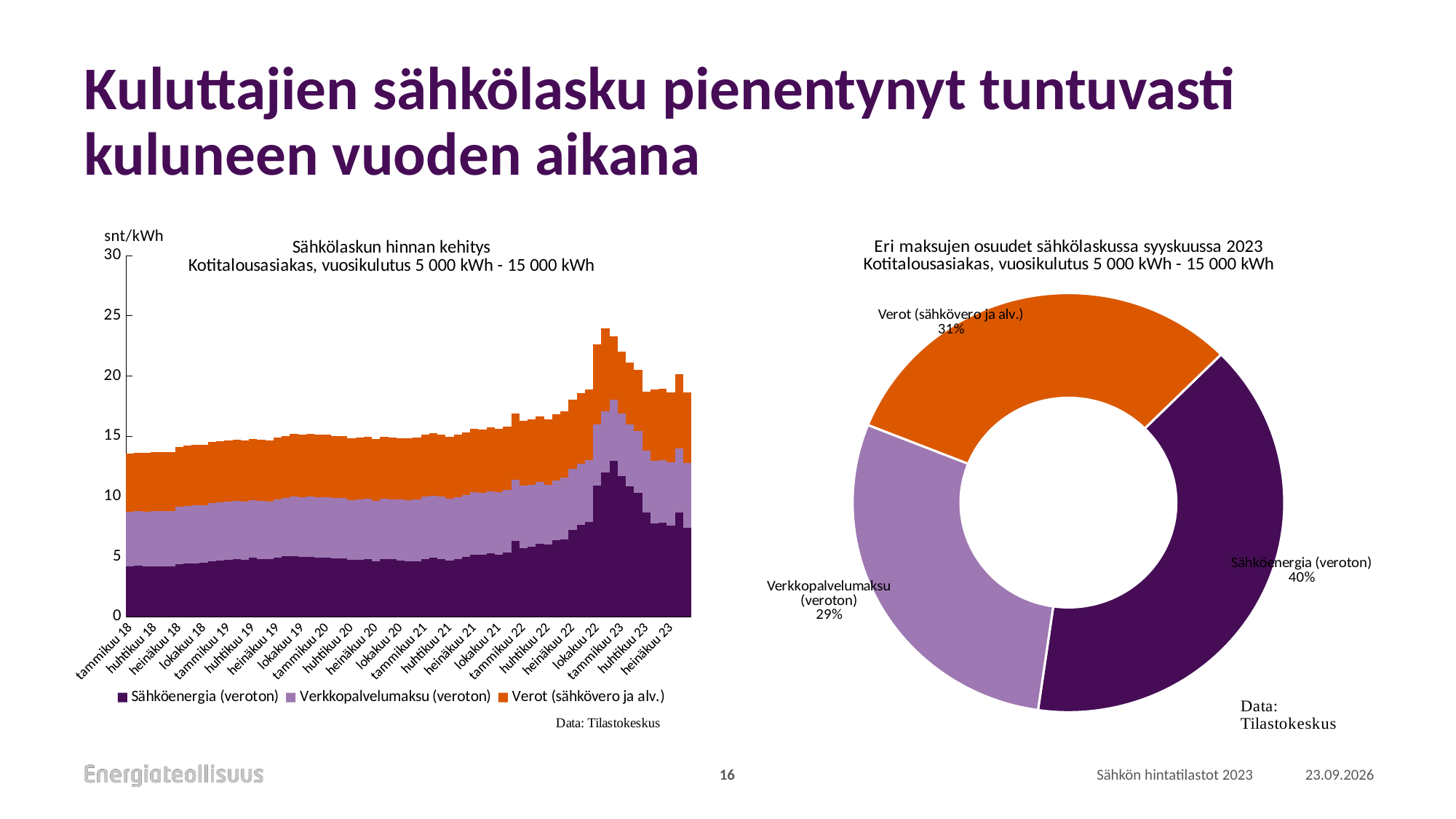
What kind of chart is 'Sähkölaskun hinnan kehitys'? Stacked bar chart In the chart 'Eri maksujen osuudet sähkölaskussa syyskuussa 2023', how many percentage points larger is the share of Sähköenergia (veroton) than that of Verot (sähkövero ja alv.)? 9 percentage points What kind of chart is 'Eri maksujen osuudet sähkölaskussa syyskuussa 2023'? Pie (donut) chart In the chart 'Eri maksujen osuudet sähkölaskussa syyskuussa 2023', how many slices are there? 3 How many series does the legend of the chart 'Sähkölaskun hinnan kehitys' list? 3 In the chart 'Eri maksujen osuudet sähkölaskussa syyskuussa 2023', what share does Sähköenergia (veroton) have? 40% In the chart 'Eri maksujen osuudet sähkölaskussa syyskuussa 2023', which component has the smallest share? Verkkopalvelumaksu (veroton) In the chart 'Sähkölaskun hinnan kehitys', what unit is shown on the vertical axis? snt/kWh In the chart 'Eri maksujen osuudet sähkölaskussa syyskuussa 2023', which component has the largest share? Sähköenergia (veroton) In the chart 'Eri maksujen osuudet sähkölaskussa syyskuussa 2023', what share does Verot (sähkövero ja alv.) have? 31% In the chart 'Eri maksujen osuudet sähkölaskussa syyskuussa 2023', what share does Verkkopalvelumaksu (veroton) have? 29% In the chart 'Sähkölaskun hinnan kehitys', is the total bar height for tammikuu 18 greater or less than 15? less